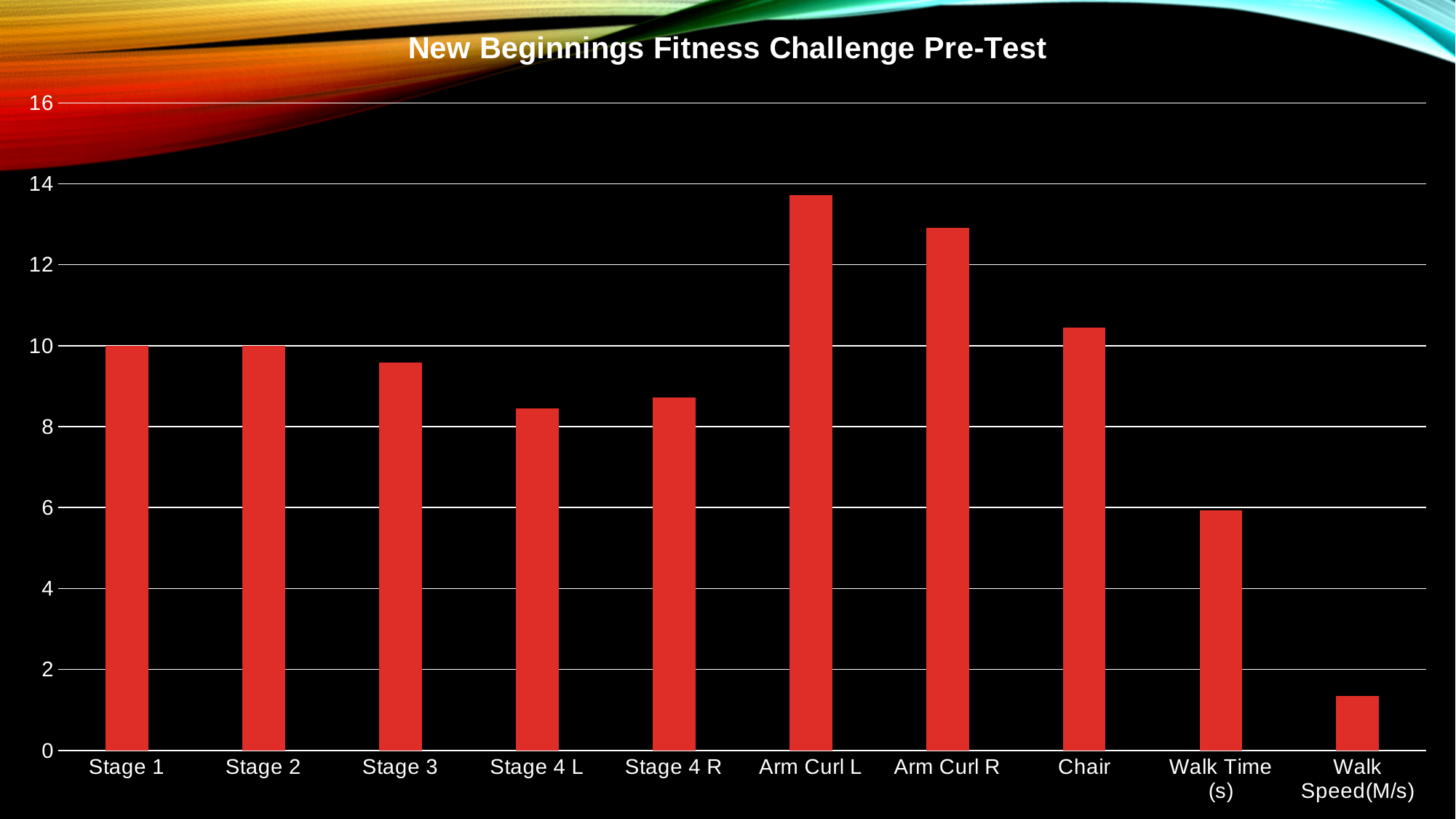
What is the value for Stage 1? 10 Is the value for Stage 4 L greater or less than 10? less Is the value for Arm Curl L greater or less than 12? greater How many categories are shown on the x axis of the chart? 10 What is the title of the chart? New Beginnings Fitness Challenge Pre-Test What type of chart is shown on the slide? Bar chart Which category has the highest value? Arm Curl L Which is larger, the value for Chair or the value for Stage 3? Chair Which category has the lowest value? Walk Speed(M/s) Which is larger, the value for Arm Curl L or the value for Arm Curl R? Arm Curl L Is the value for Walk Speed(M/s) greater or less than 2? less What is the value for Stage 2? 10